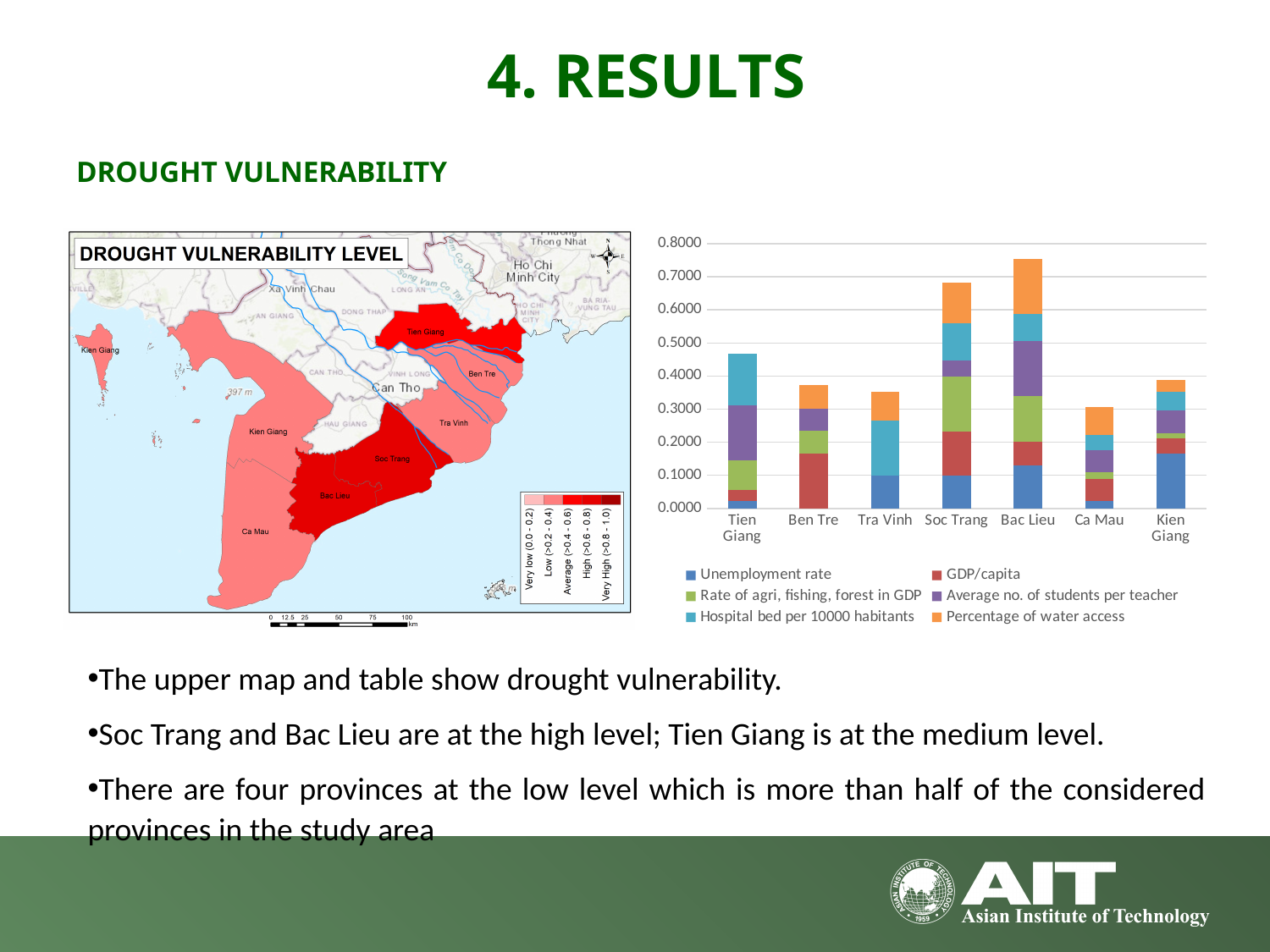
Which province has the larger total stacked bar, Soc Trang or Ben Tre? Soc Trang Which series in the bar chart is shown in orange? Percentage of water access Which province has the tallest stacked bar in the chart? Bac Lieu How many provinces are shown on the x axis of the bar chart? 7 Which series is listed first in the legend of the bar chart? Unemployment rate Is the total stacked value for Ca Mau greater or less than 0.4000? less Is the total stacked value for Bac Lieu greater or less than 0.7000? greater How many series does the legend of the bar chart list? 6 Is the total stacked value for Soc Trang greater or less than 0.6000? greater What kind of chart is shown on the right of the slide? stacked bar chart Which province has the larger total stacked bar, Tien Giang or Kien Giang? Tien Giang